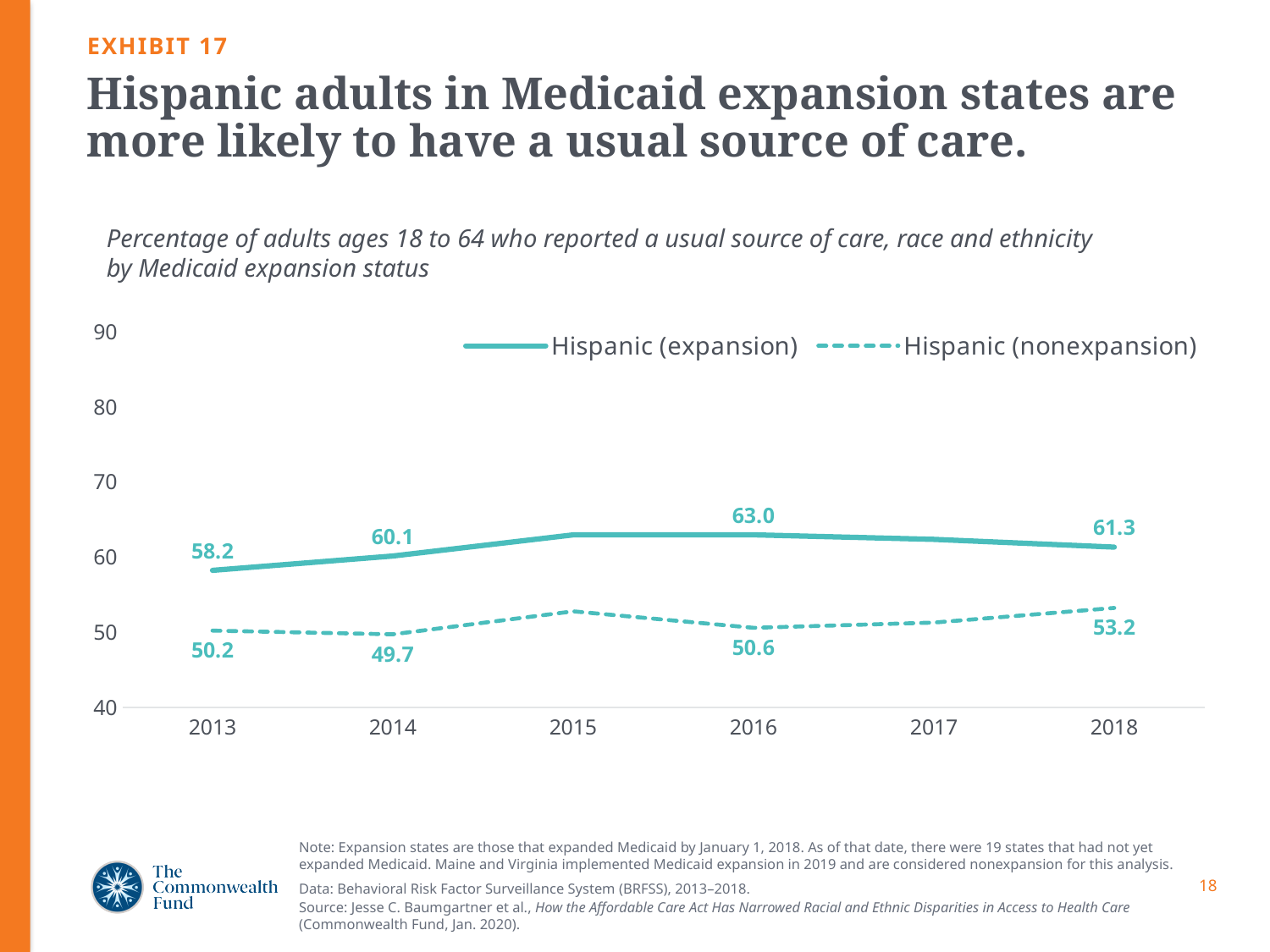
What is the value for Hispanic (expansion) in 2016? 63.0 Does the Hispanic (expansion) line rise or fall from 2013 to 2016? Rise Is the value for Hispanic (expansion) in 2015 greater or less than 60? greater What is the value for Hispanic (expansion) in 2013? 58.2 What kind of chart is shown on the slide? Line chart How many series does the legend list? 2 Which series has the higher value in 2016, Hispanic (expansion) or Hispanic (nonexpansion)? Hispanic (expansion) What is the value for Hispanic (nonexpansion) in 2018? 53.2 How many years are shown on the x axis? 6 In which year is the Hispanic (nonexpansion) value lowest? 2014 What is the value for Hispanic (nonexpansion) in 2014? 49.7 What is the difference between the Hispanic (expansion) and Hispanic (nonexpansion) values in 2018? 8.1